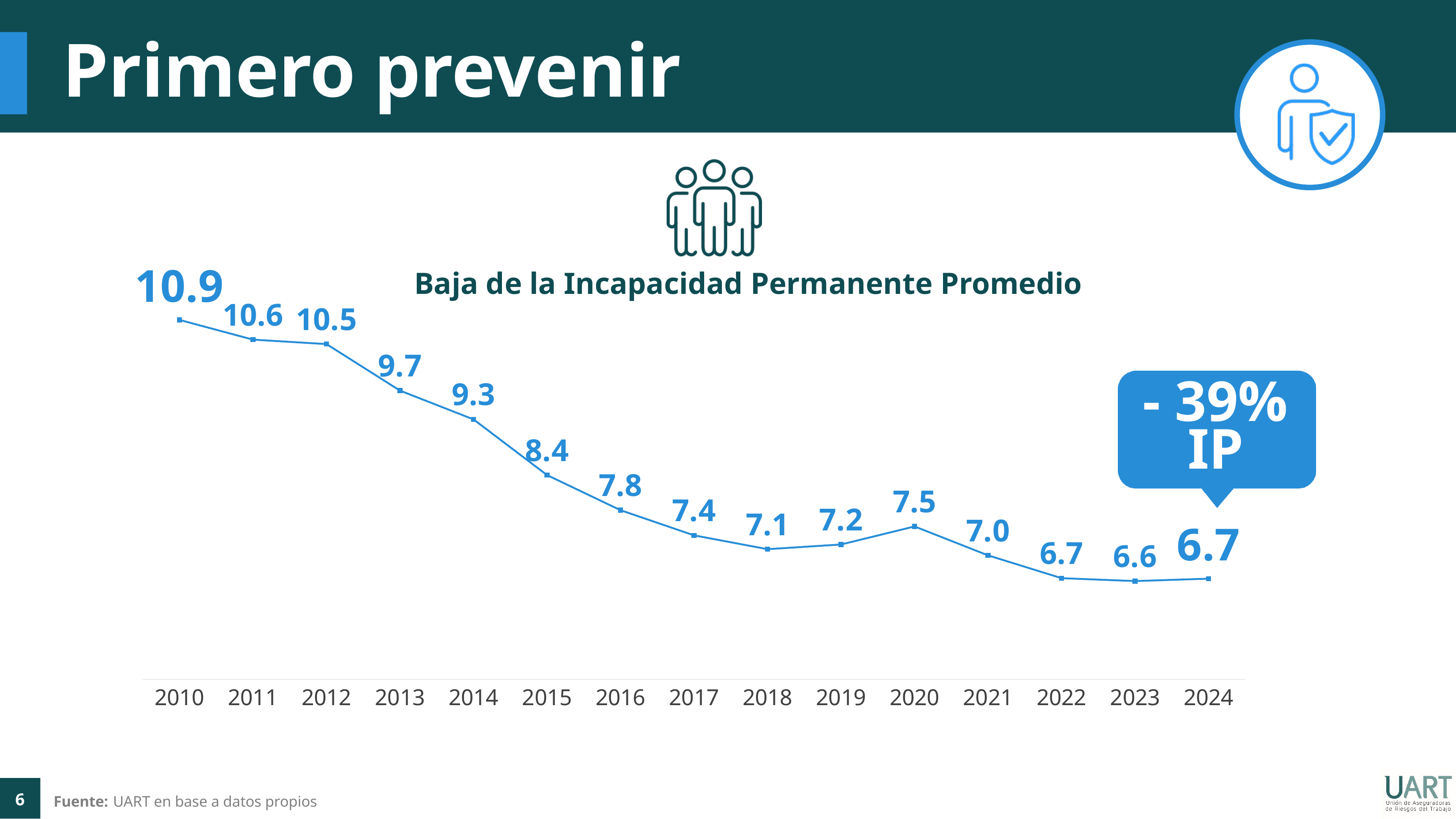
What is the value for 2024? 6.7 What is the value for 2010? 10.9 Which year has the lowest value? 2023 What kind of chart is shown? Line chart Which is larger, the value for 2019 or the value for 2020? 2020 What is the difference between the values for 2010 and 2024? 4.2 Which year has the highest value? 2010 What is the value for 2015? 8.4 What is the title of the chart? Baja de la Incapacidad Permanente Promedio Do the values generally rise or fall from 2010 to 2024? Fall How many years are plotted on the chart? 15 What is the value for 2020? 7.5